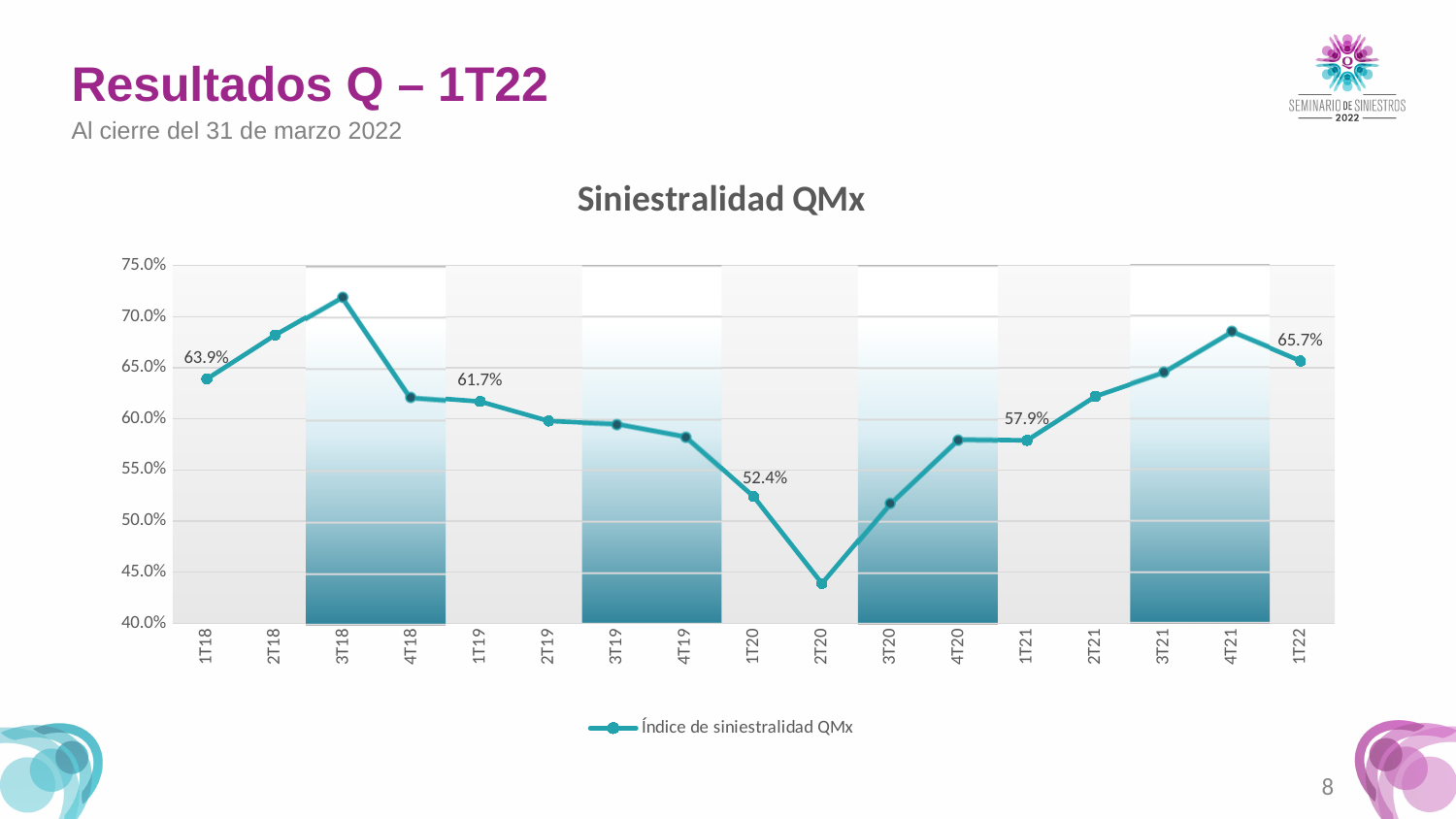
What is the value for 1T22? 65.7% Which quarter has the highest value? 3T18 Is the value for 2T20 greater or less than 45.0%? less What is the title of the chart? Siniestralidad QMx What type of chart is shown on the slide? line chart What is the value for 1T21? 57.9% What is the value for 1T19? 61.7% How many quarters are plotted on the x axis? 17 What is the value for 1T20? 52.4% What is the value for 1T18? 63.9% Which quarter has the lowest value? 2T20 What is the difference between the values for 1T22 and 1T21? 7.8%